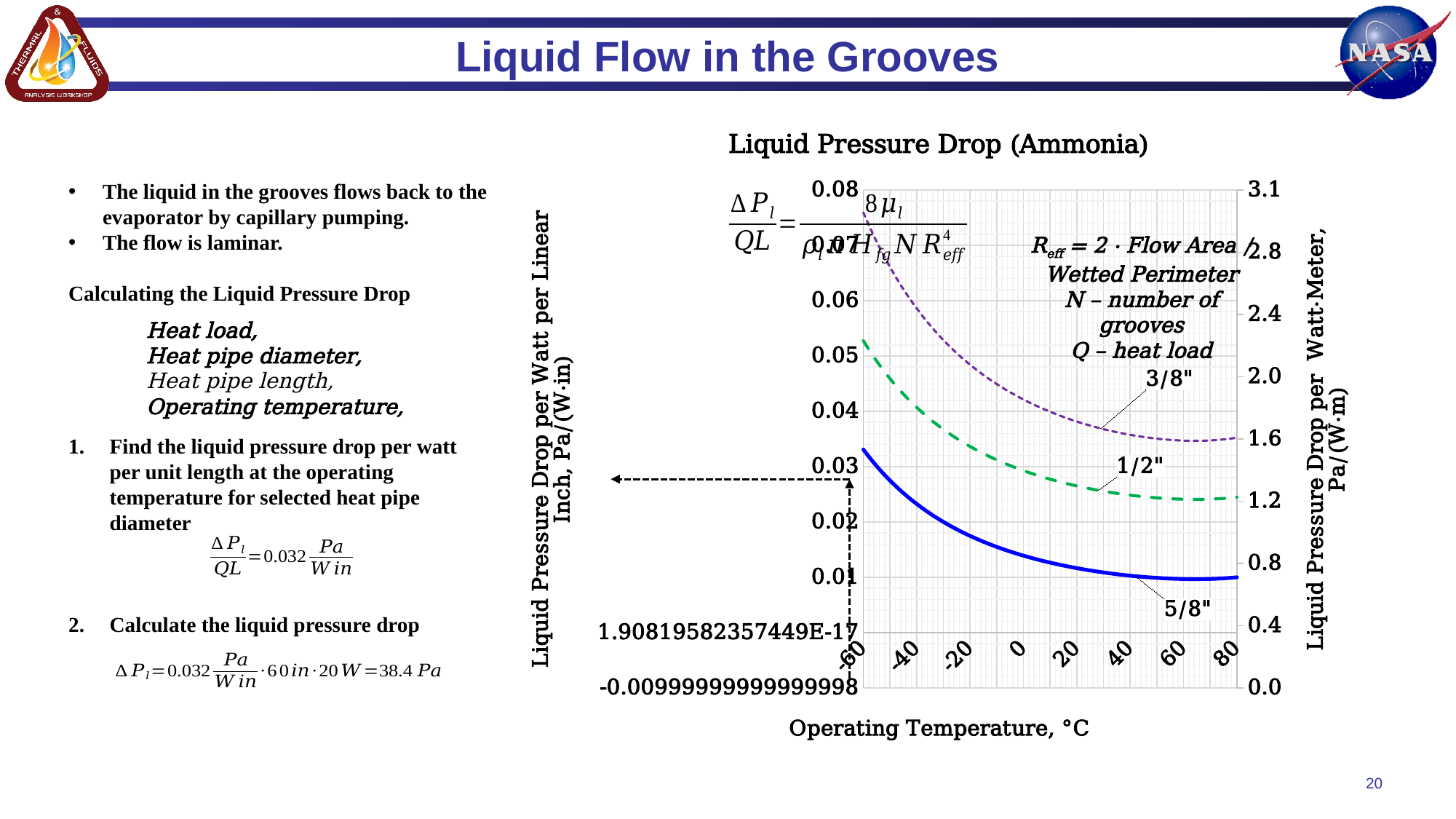
Which heat pipe diameter has the highest liquid pressure drop per watt per linear inch across the temperature range? 3/8" What is the title of the chart on the slide? Liquid Pressure Drop (Ammonia) Do the liquid pressure drop curves rise or fall as operating temperature increases from -60 °C to 60 °C? fall Is the value for the 1/2" curve at 80 °C greater or less than 0.03 Pa/(W·in)? less Is the value for the 3/8" curve at 80 °C greater or less than 0.03 Pa/(W·in)? greater Is the value for the 5/8" curve at 80 °C greater or less than 0.02 Pa/(W·in)? less Which heat pipe diameter has the lowest liquid pressure drop per watt per linear inch across the temperature range? 5/8" What is the label of the x axis of the chart? Operating Temperature, °C What kind of chart is shown on the slide? line chart At 0 °C, which curve is higher: 1/2" or 5/8"? 1/2" How many heat pipe diameter series are plotted on the chart? 3